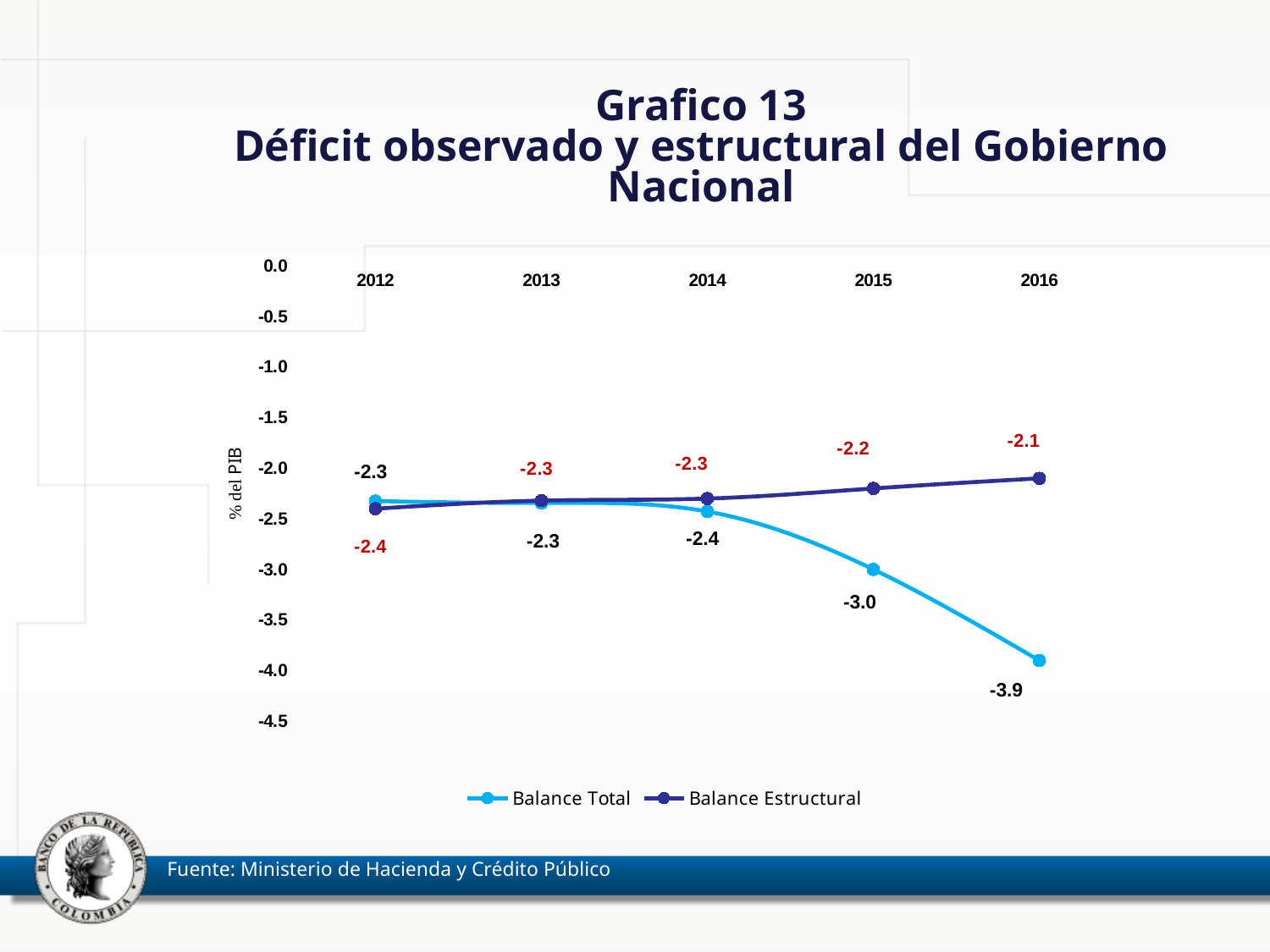
How many series does the legend list? 2 What is the value of Balance Total in 2016? -3.9 What is the label of the y axis? % del PIB What is the value of Balance Estructural in 2012? -2.4 What is the difference between Balance Estructural and Balance Total in 2016? 1.8 Which series has the higher value in 2015, Balance Total or Balance Estructural? Balance Estructural How many years are plotted on the x axis? 5 What is the value of Balance Estructural in 2016? -2.1 What type of chart is shown on the slide? line chart Does Balance Total rise or fall from 2014 to 2016? fall In which year is Balance Total lowest? 2016 What is the value of Balance Total in 2015? -3.0